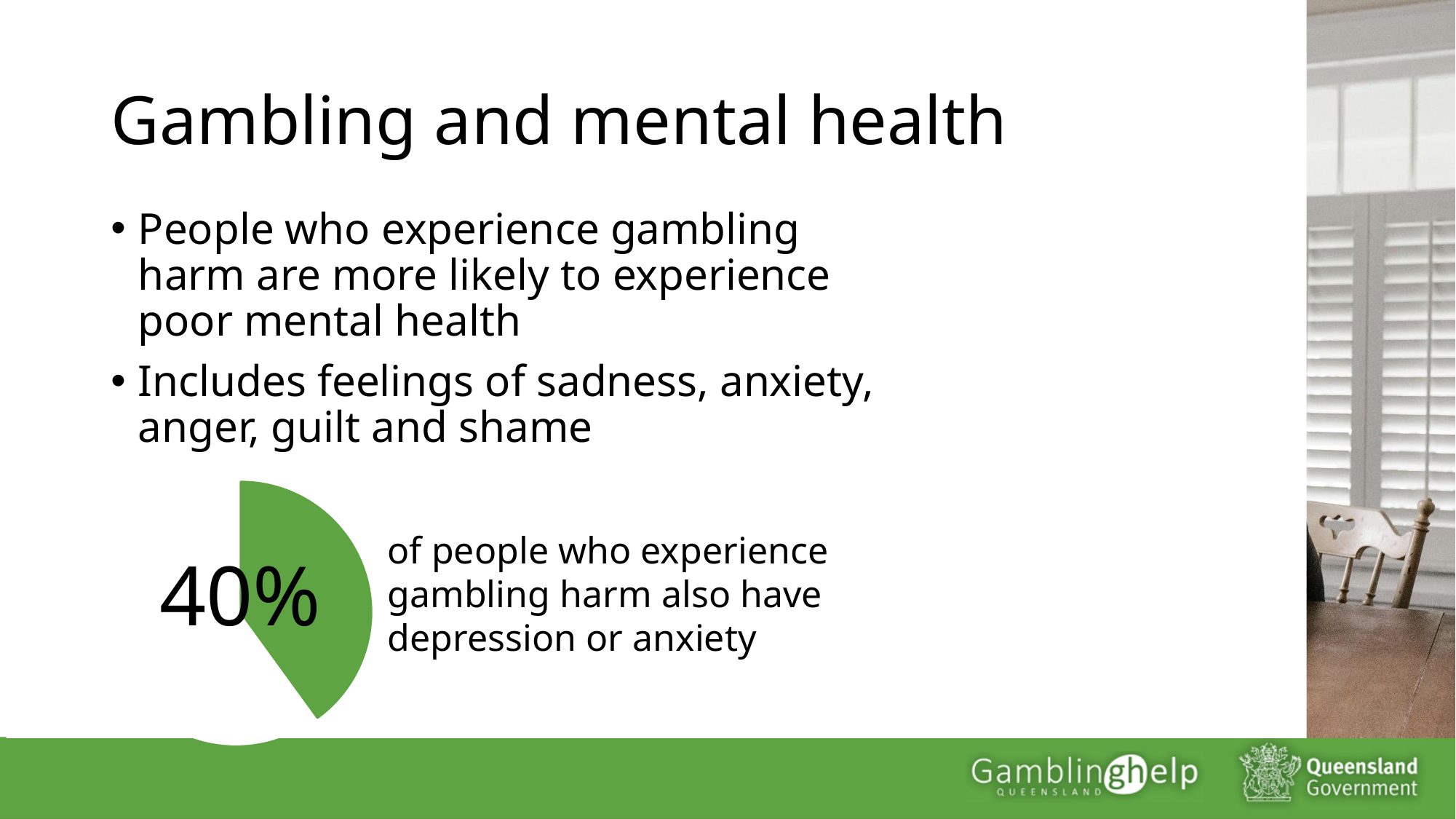
What is the title of the slide containing the pie chart? Gambling and mental health What share of the pie does the green slice represent? 40% What percentage of people who experience gambling harm also have depression or anxiety, according to the chart? 40% What colour is the highlighted slice of the pie chart? green Is the value shown by the green slice greater or less than 50%? less What kind of chart is shown on the slide? pie chart